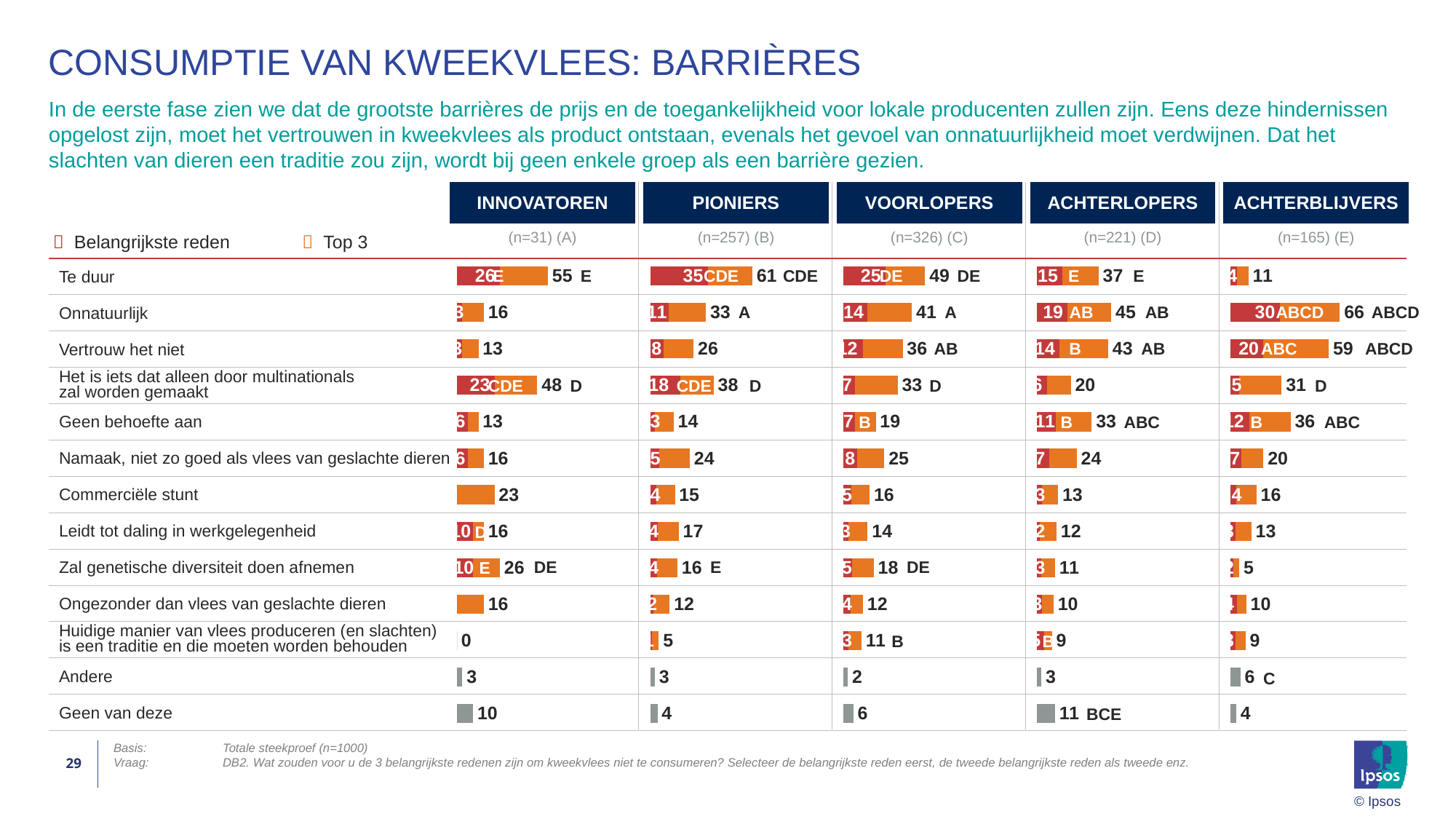
What is the difference between the Top 3 values for 'Te duur' among the Pioniers and the Achterblijvers? 50 What is the sample size (n) shown for the Voorlopers group? 326 How many barrier reasons are listed in the chart? 13 Which group has the lowest Top 3 value for 'Te duur'? Achterblijvers What is the Top 3 value for 'Te duur' among the Pioniers? 61 Do the Top 3 values for 'Onnatuurlijk' rise or fall from Innovatoren to Achterblijvers? Rise What is the Top 3 value for 'Onnatuurlijk' among the Achterblijvers? 66 For 'Vertrouw het niet', is the Top 3 value higher among the Voorlopers or the Achterblijvers? Achterblijvers What is the 'Belangrijkste reden' value for 'Te duur' among the Pioniers? 35 What kind of chart is used to show the values? Bar chart Which group has the highest Top 3 value for 'Onnatuurlijk'? Achterblijvers How many series does the legend list? 2